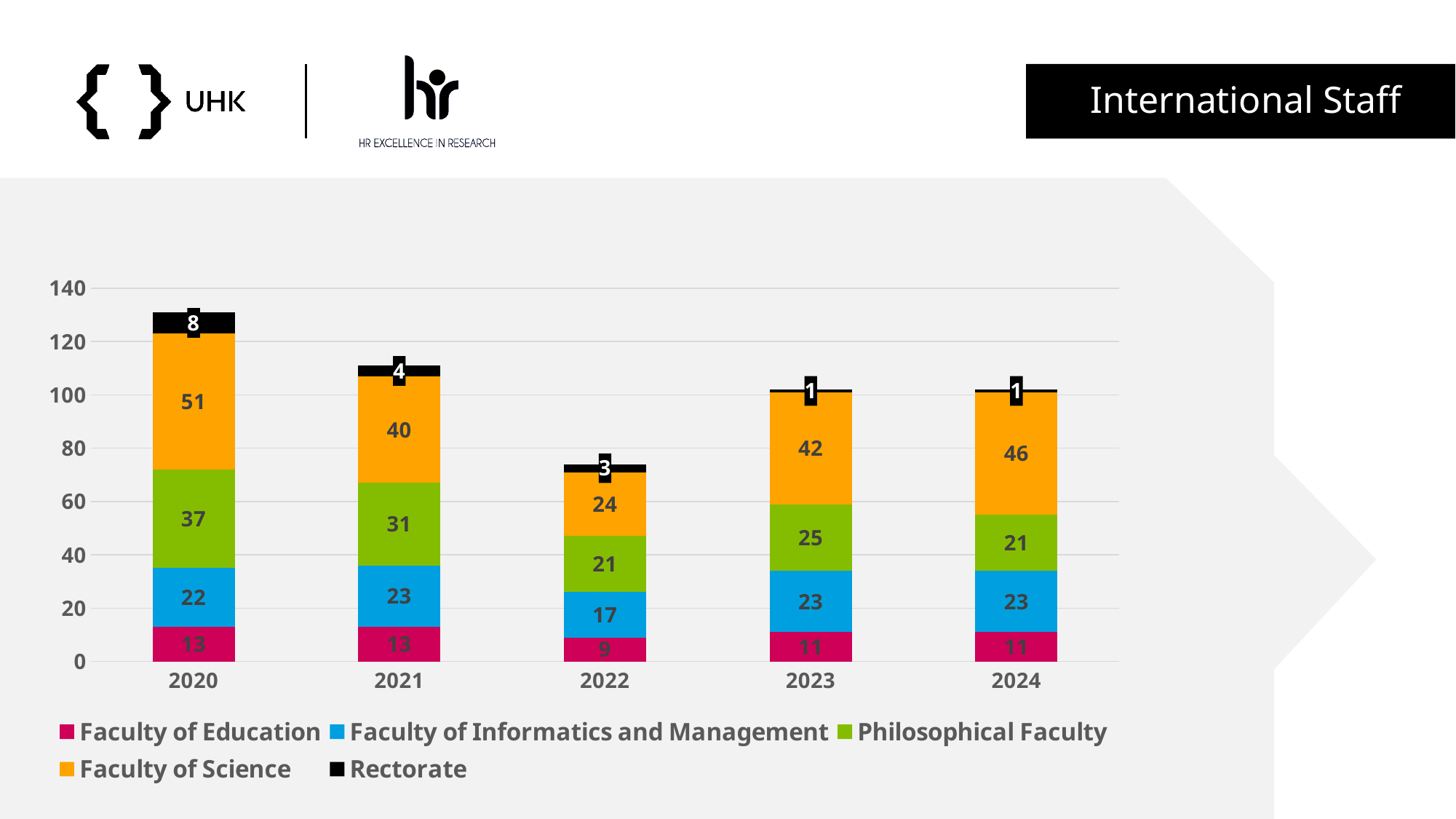
In which year is the Faculty of Education value lowest? 2022 What is the value for Rectorate in 2021? 4 What kind of chart is shown on the slide? Stacked bar chart Is the total of the stacked bar for 2020 greater or less than 120? greater What is the difference between the Faculty of Science values in 2024 and 2023? 4 How many series does the legend list? 5 What is the value for Philosophical Faculty in 2023? 25 How many years are shown on the x axis? 5 In which year is the Faculty of Science value highest? 2020 What is the value for Faculty of Science in 2020? 51 Which is larger: Philosophical Faculty in 2021 or Philosophical Faculty in 2024? Philosophical Faculty in 2021 What is the total of the stacked bar for 2022? 74